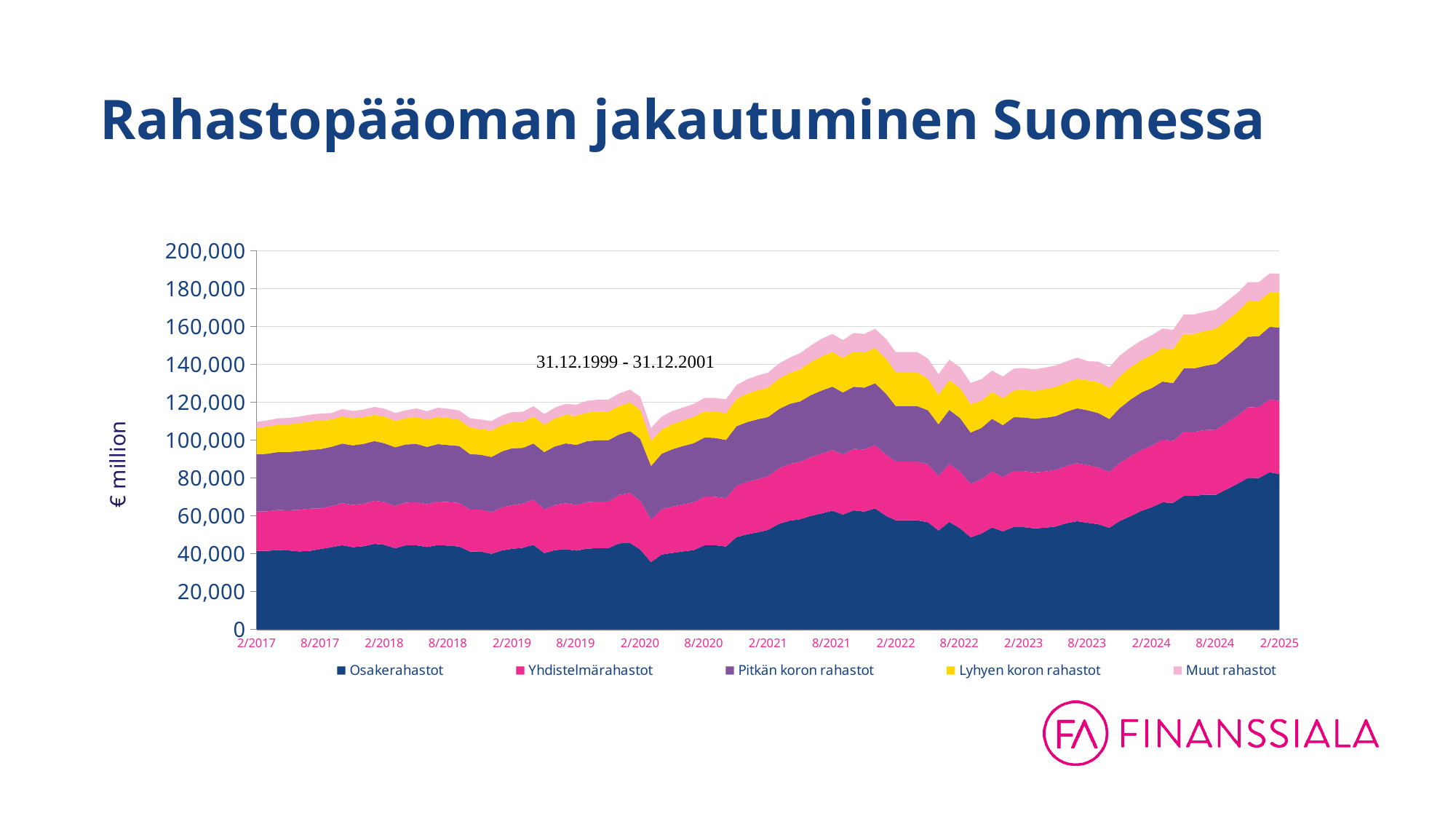
Is the total stacked value at 2/2025 greater or less than 180,000? greater Which series forms the bottom layer of the stacked area? Osakerahastot How many series does the legend list? 5 How many date labels are shown on the x axis? 17 What is the title of the chart? Rahastopääoman jakautuminen Suomessa What is the label on the vertical axis? € million What kind of chart is shown on the slide? Stacked area chart Which series is the largest at 2/2025? Osakerahastot Is the total stacked value at 2/2017 greater or less than 100,000? greater Does the total fund capital rise or fall overall from 2/2017 to 2/2025? rise Is the value for Osakerahastot at 2/2017 greater or less than 60,000? less Which series is the smallest at 2/2025? Muut rahastot